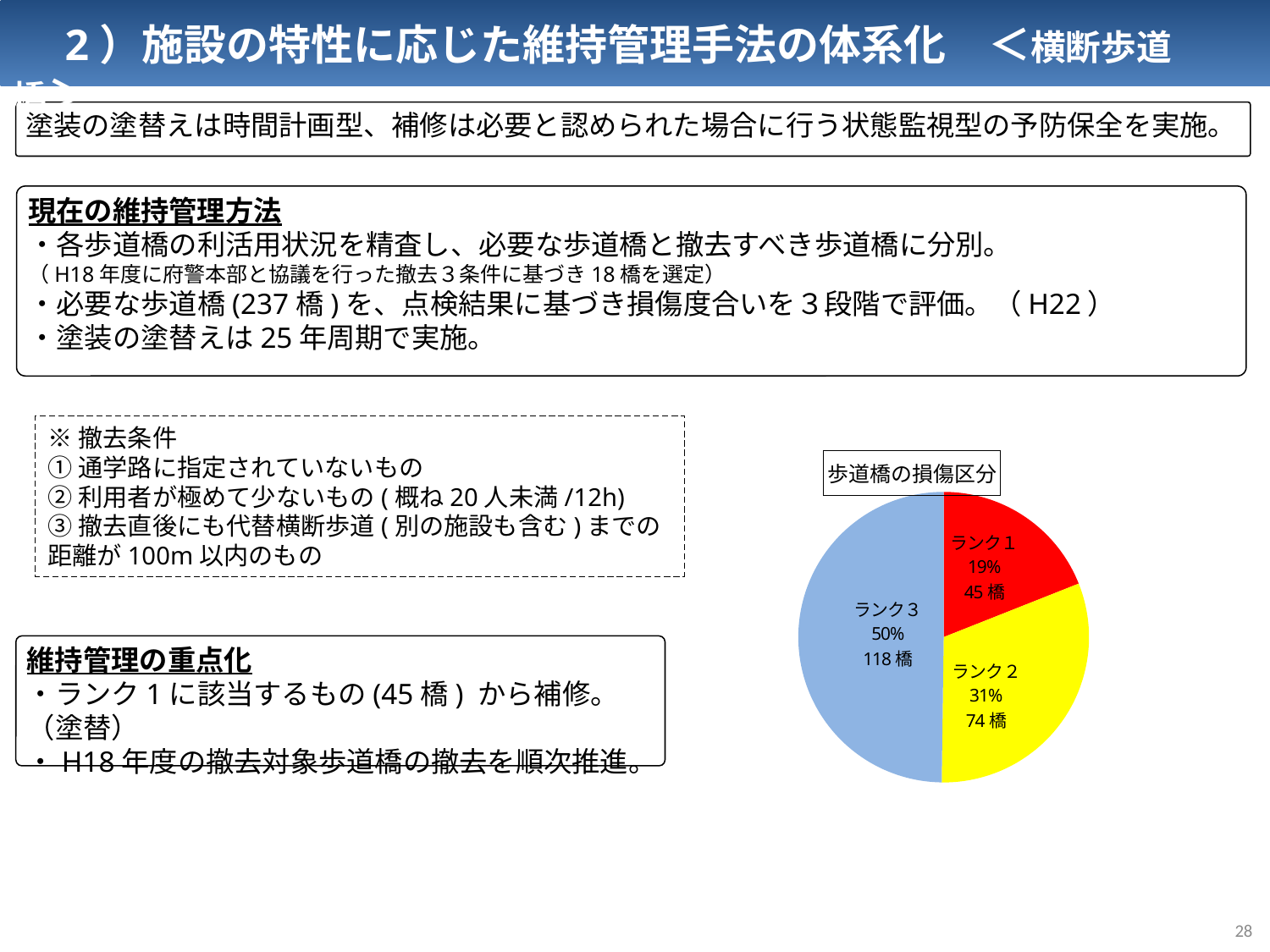
What percentage share does ランク3 have in the pie chart? 50% How many bridges (橋) are in ランク2 according to the pie chart? 74橋 What type of chart is shown on the slide? pie chart What percentage share does ランク1 have in the pie chart? 19% How many bridges (橋) are in ランク1 according to the pie chart? 45橋 What is the difference in the number of bridges between ランク3 and ランク2 in the pie chart? 44橋 Which rank has the smallest slice in the pie chart? ランク1 What is the title of the pie chart? 歩道橋の損傷区分 Which rank has the largest slice in the pie chart? ランク3 How many bridges (橋) are in ランク3 according to the pie chart? 118橋 What percentage share does ランク2 have in the pie chart? 31% How many slices does the pie chart have? 3